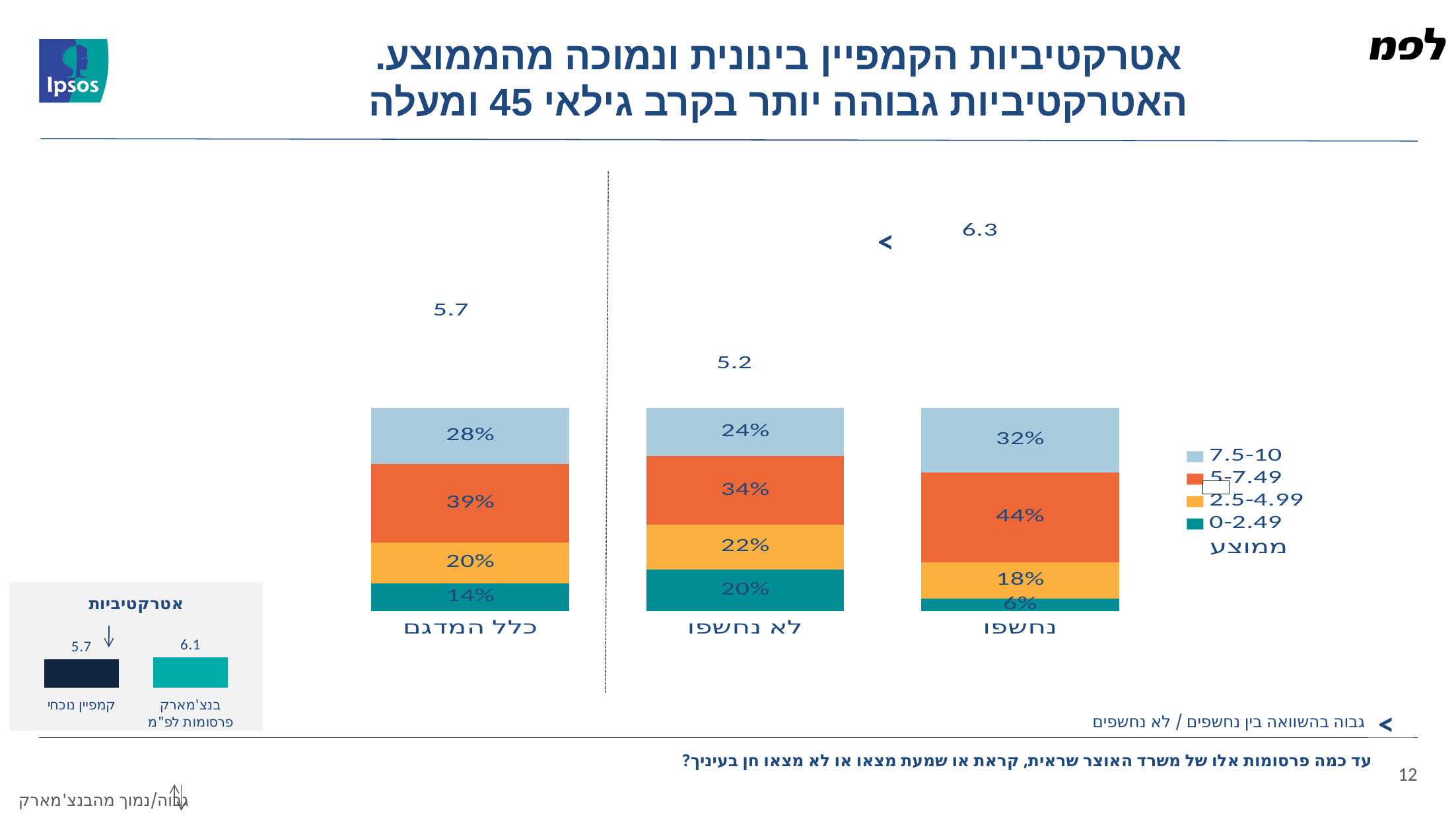
How many groups (bars) are shown in the main stacked bar chart? 3 In the main stacked bar chart, what is the average shown above the כלל המדגם bar? 5.7 In the small bar chart at the bottom left (אטרקטיביות), what is the value for בנצ'מארק פרסומות לפ"מ? 6.1 In the main stacked bar chart, what is the average (ממוצע) shown above the נחשפו bar? 6.3 In the main stacked bar chart, which group has the highest share in the 7.5-10 range? נחשפו What type of chart is the main chart on the slide? Stacked bar chart In the main stacked bar chart, is the 2.5-4.99 share larger for כלל המדגם or for לא נחשפו? לא נחשפו How many score ranges does the legend of the main stacked bar chart list? 4 In the main stacked bar chart, what is the difference between the 5-7.49 shares of נחשפו and לא נחשפו? 10 percentage points In the main stacked bar chart, what percentage of the לא נחשפו group falls in the 0-2.49 range? 20% In the main stacked bar chart, which group has the lowest share in the 0-2.49 range? נחשפו In the main stacked bar chart, what percentage of the נחשפו group falls in the 5-7.49 range? 44%